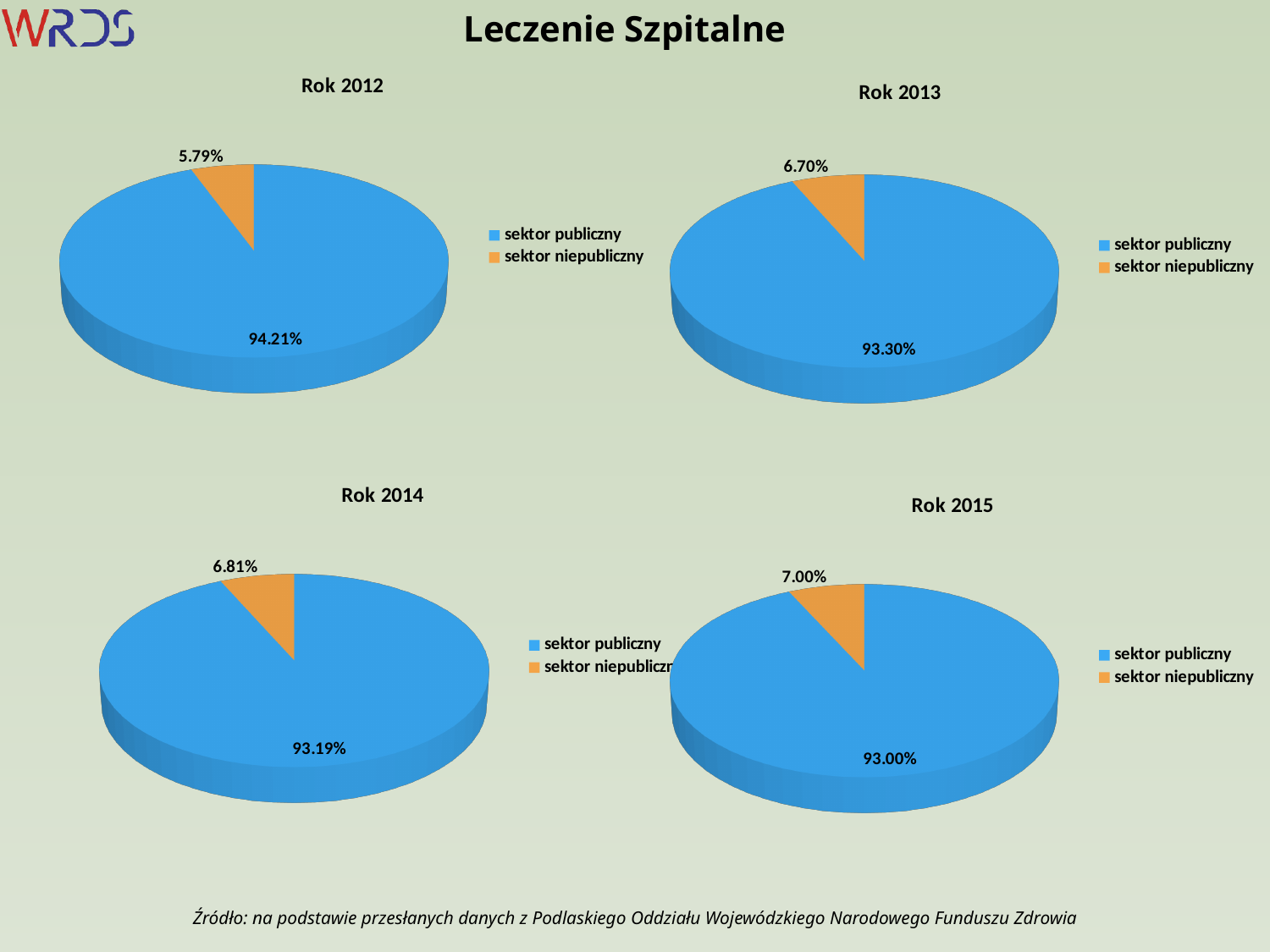
In the 'Rok 2014' chart, what colour is the sektor niepubliczny slice? orange How many slices does the 'Rok 2015' chart have? 2 In the 'Rok 2013' chart, what is the difference between sektor publiczny and sektor niepubliczny? 86.60% In the 'Rok 2012' chart, which sector has the largest slice? sektor publiczny In the 'Rok 2012' chart, what is the value for sektor niepubliczny? 5.79% How many entries does the legend of the 'Rok 2013' chart list? 2 In the 'Rok 2014' chart, what is the value for sektor niepubliczny? 6.81% In the 'Rok 2014' chart, which is larger, sektor publiczny or sektor niepubliczny? sektor publiczny In the 'Rok 2015' chart, which sector has the smallest slice? sektor niepubliczny In the 'Rok 2013' chart, what is the value for sektor publiczny? 93.30% What kind of chart is the 'Rok 2012' chart? pie chart In the 'Rok 2015' chart, what is the value for sektor publiczny? 93.00%